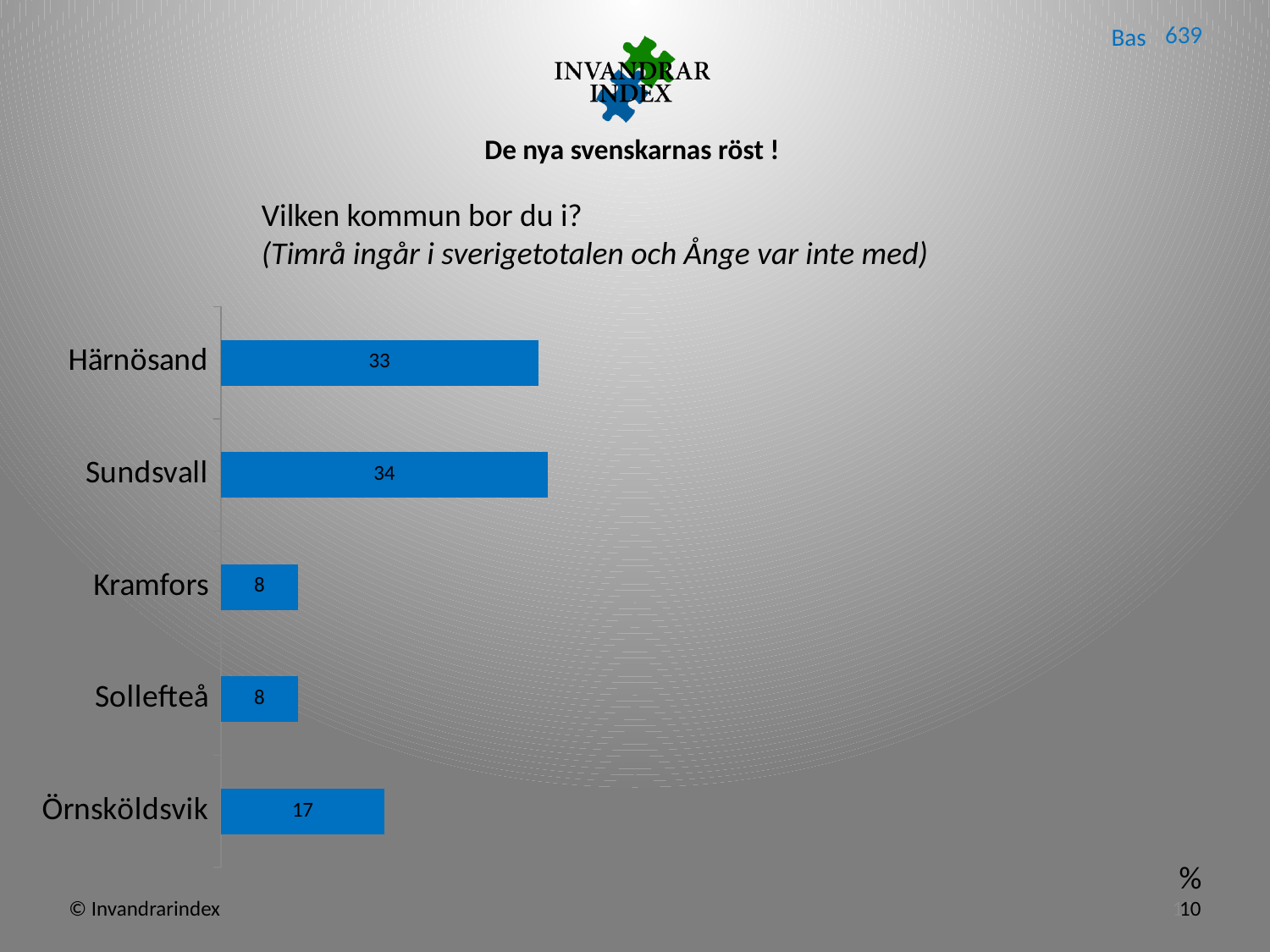
What is the difference between the values for Härnösand and Kramfors? 25 What kind of chart is shown on the slide? Bar chart What is the value for Sollefteå? 8 How many municipalities are shown in the chart? 5 What is the value for Sundsvall? 34 Which is larger, the value for Örnsköldsvik or the value for Sollefteå? Örnsköldsvik What is the value for Härnösand? 33 Which municipality has the highest value? Sundsvall What is the value for Kramfors? 8 What is the value for Örnsköldsvik? 17 What is the 'Bas' (base) number shown on the slide? 639 What is the difference between the values for Sundsvall and Örnsköldsvik? 17